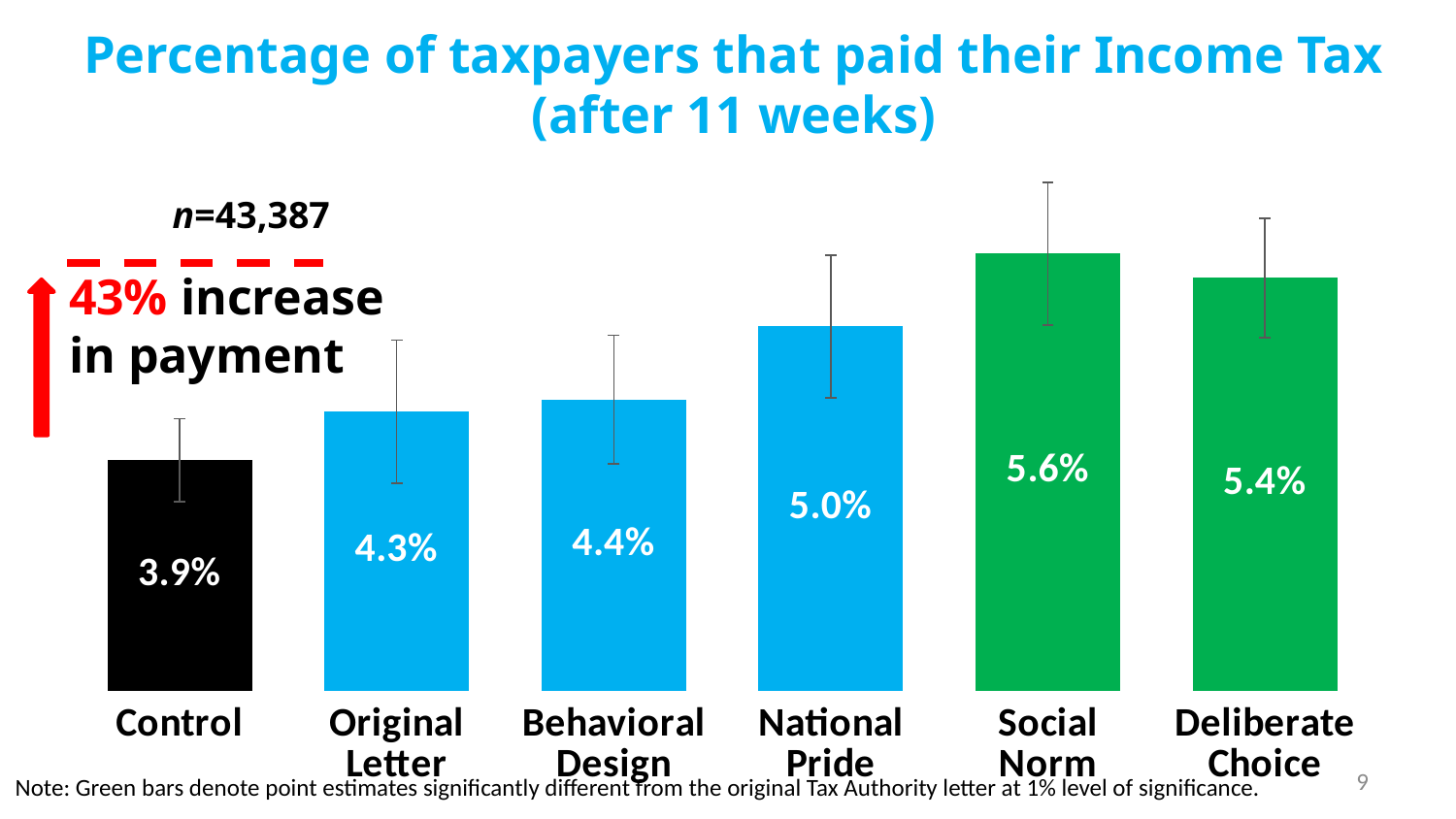
What is the value for the Deliberate Choice bar? 5.4% Which is larger, the value for National Pride or the value for Behavioral Design? National Pride What is the difference between the Social Norm value and the Control value? 1.7% What is the difference between the Behavioral Design value and the Original Letter value? 0.1% What is the value for the Social Norm bar? 5.6% What kind of chart is shown on the slide? Bar chart What sample size (n) is stated on the slide? 43,387 What is the value for the National Pride bar? 5.0% What percentage of taxpayers paid their income tax in the Control group? 3.9% How many categories are shown in the chart? 6 Which category has the lowest percentage of taxpayers paying their income tax? Control Which category has the highest percentage of taxpayers paying their income tax? Social Norm